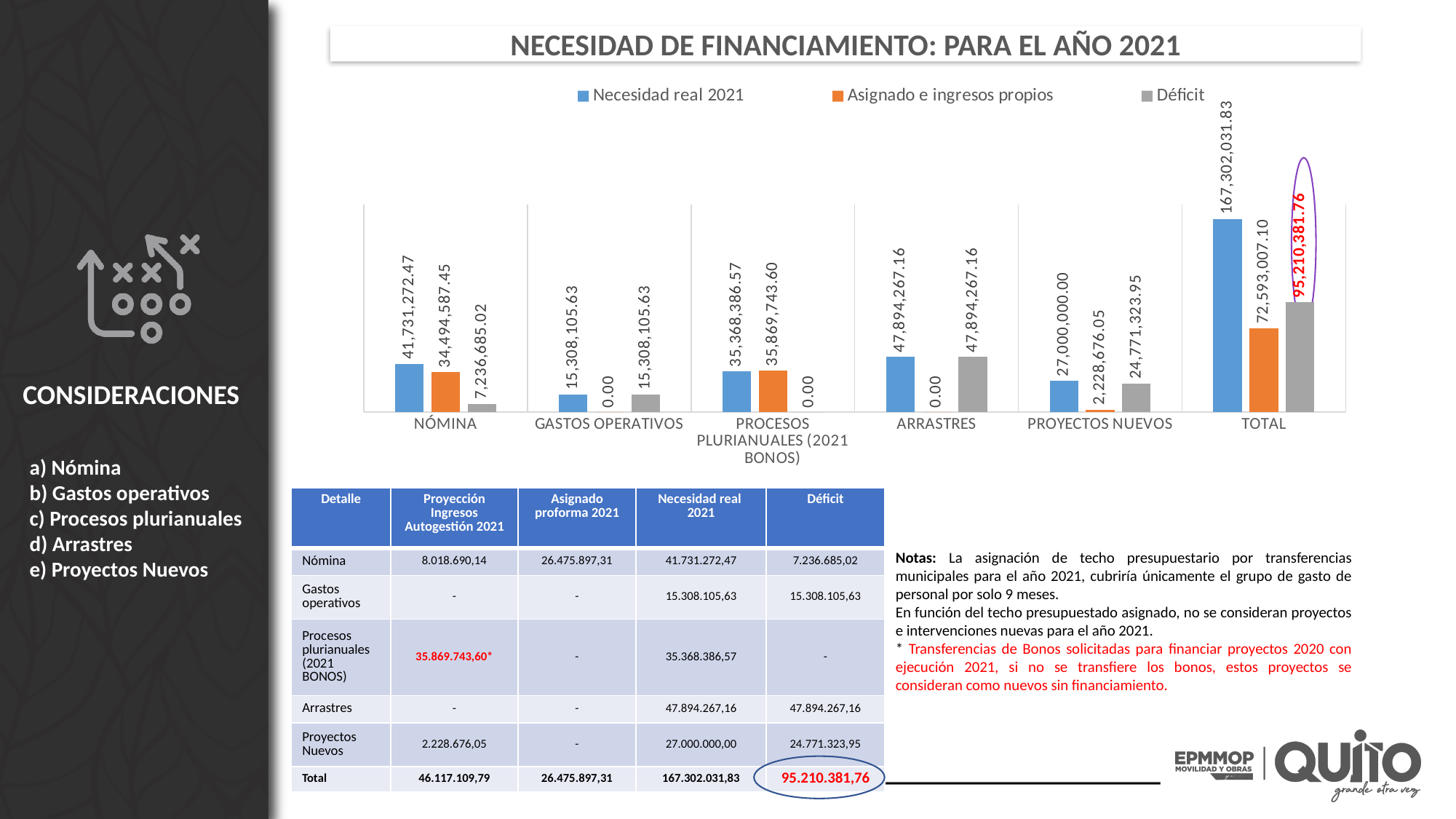
How many categories are shown on the x axis of the chart? 6 What is the value of Asignado e ingresos propios for PROYECTOS NUEVOS? 2,228,676.05 What is the Déficit value for TOTAL? 95,210,381.76 Excluding TOTAL, which category has the lowest Déficit value? PROCESOS PLURIANUALES (2021 BONOS) What is the title of the chart? NECESIDAD DE FINANCIAMIENTO: PARA EL AÑO 2021 Which is larger for PROCESOS PLURIANUALES (2021 BONOS): Necesidad real 2021 or Asignado e ingresos propios? Asignado e ingresos propios What is the difference between Necesidad real 2021 and Asignado e ingresos propios for TOTAL? 94,709,024.73 What type of chart is shown on the slide? Bar chart What is the Déficit value for ARRASTRES? 47,894,267.16 How many series does the chart legend list? 3 What is the value of Necesidad real 2021 for NÓMINA? 41,731,272.47 Excluding TOTAL, which category has the highest Necesidad real 2021 value? ARRASTRES